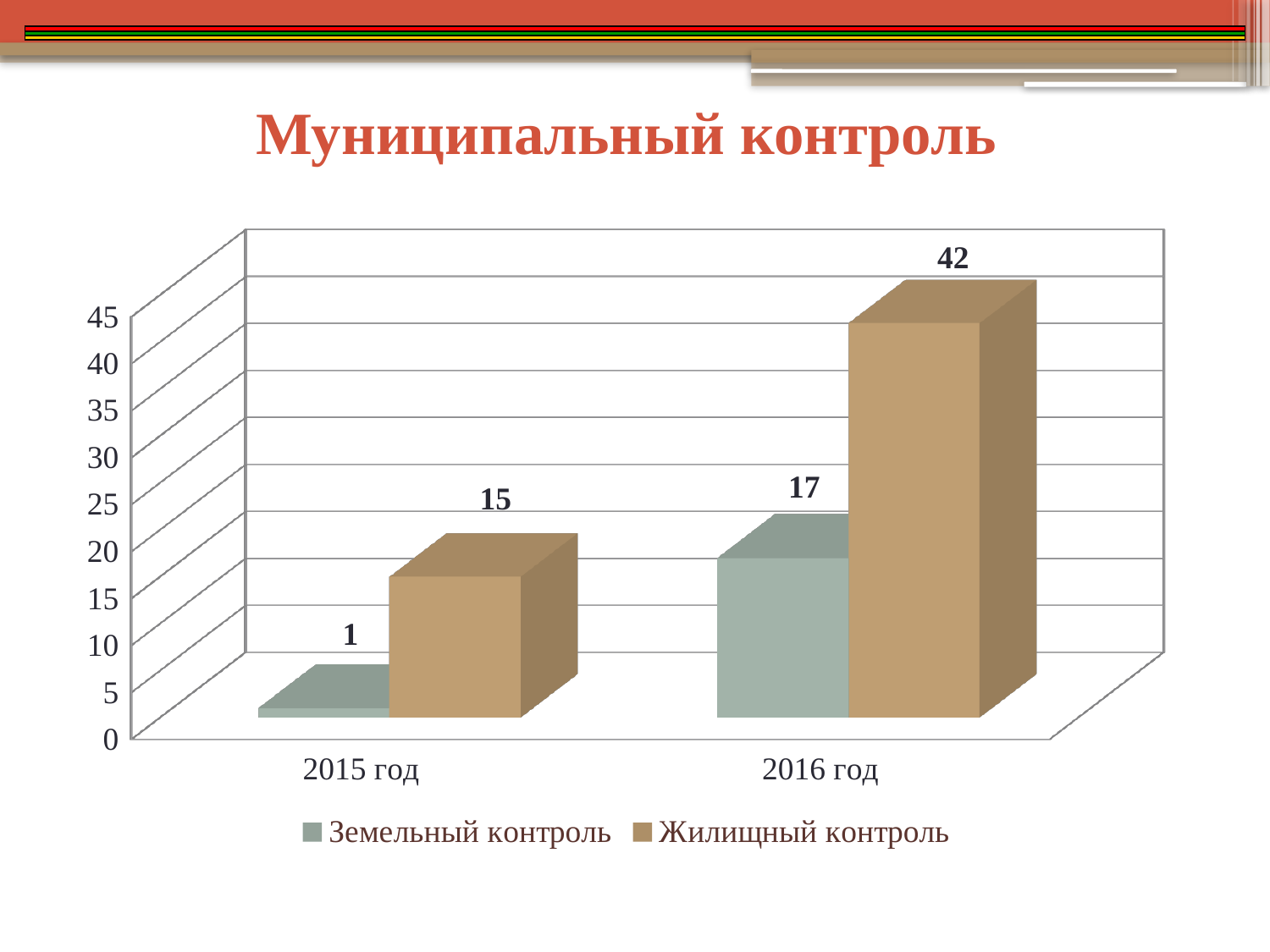
How many year categories are shown on the x axis? 2 What is the value for Жилищный контроль in 2016 год? 42 What is the value for Земельный контроль in 2015 год? 1 What is the value for Земельный контроль in 2016 год? 17 What kind of chart is shown on the slide? Bar chart What is the value for Жилищный контроль in 2015 год? 15 What is the difference between Жилищный контроль in 2016 год and in 2015 год? 27 Which year has the lowest value for Земельный контроль? 2015 год How many series does the legend list? 2 What is the title of the slide? Муниципальный контроль Which is larger in 2016 год: Земельный контроль or Жилищный контроль? Жилищный контроль Which year has the highest value for Жилищный контроль? 2016 год